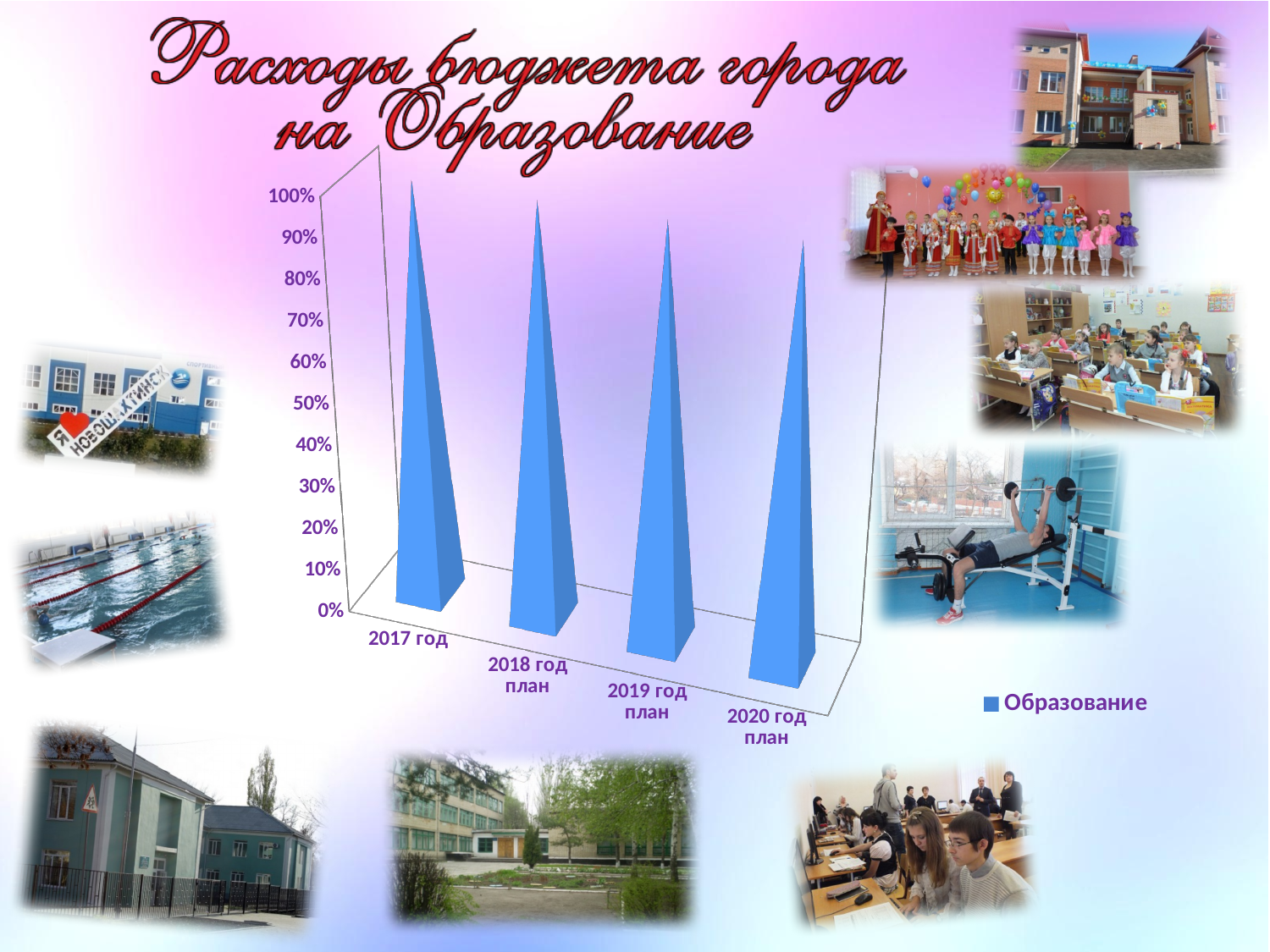
How many categories are shown on the x axis of the chart? 4 Is the value for 2020 год план greater or less than 50%? greater What is the highest value shown on the chart's vertical axis? 100% How many series does the chart legend list? 1 What kind of chart is shown on the slide? bar chart Is the value for 2018 год план greater or less than 50%? greater What is the title of the chart on the slide? Расходы бюджета города на Образование Is the value for 2017 год greater or less than 50%? greater What series name is shown in the chart legend? Образование